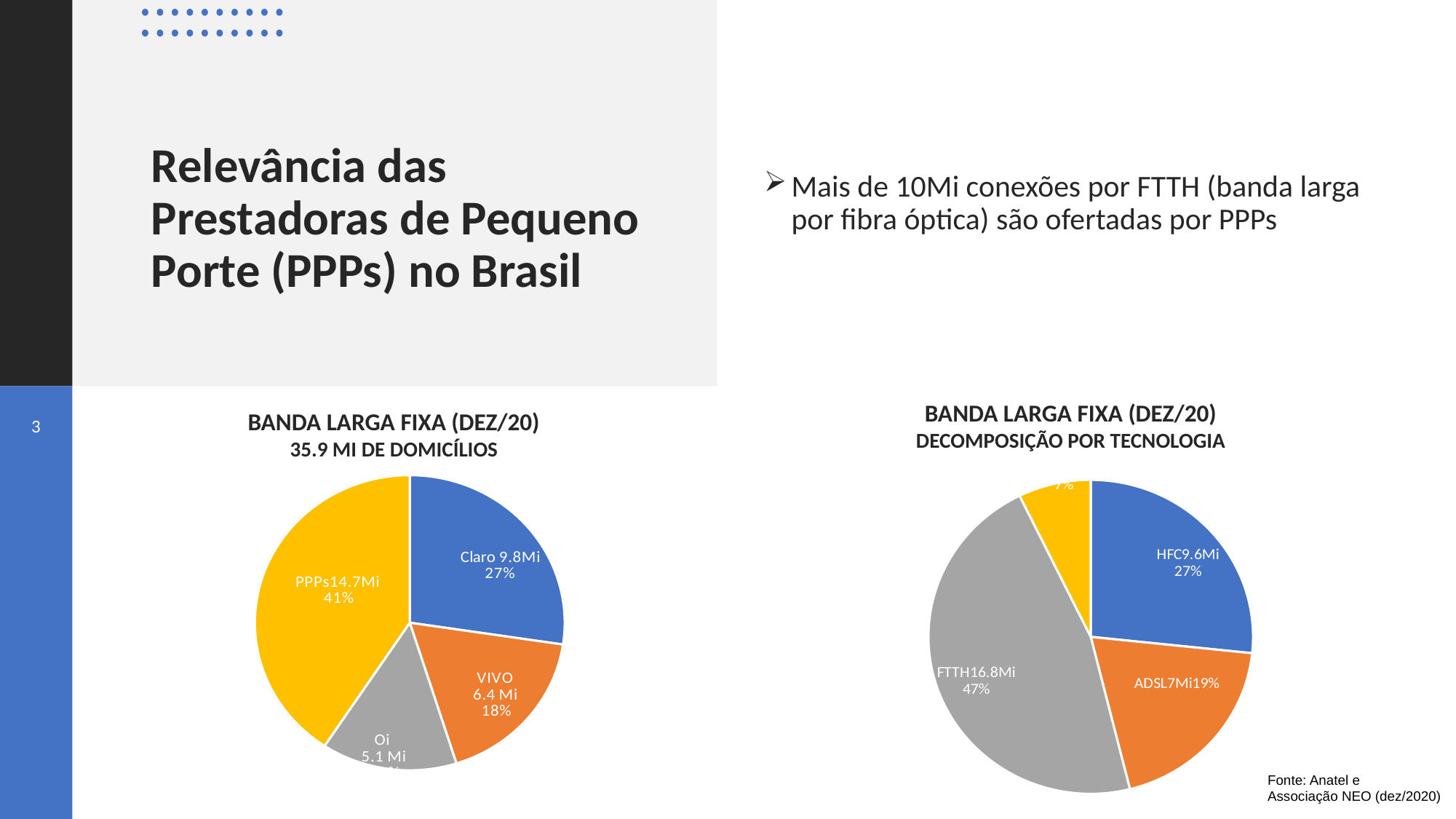
In the left pie chart (35.9 MI DE DOMICÍLIOS), what share of the pie does VIVO hold? 18% In the left pie chart (35.9 MI DE DOMICÍLIOS), what is the difference in percentage points between the PPPs share and the Claro share? 14 percentage points In the left pie chart (35.9 MI DE DOMICÍLIOS), how many slices does the pie have? 4 In the right pie chart (DECOMPOSIÇÃO POR TECNOLOGIA), which is larger, HFC or ADSL? HFC In the left pie chart (35.9 MI DE DOMICÍLIOS), what value is shown for Claro? 9.8Mi In the left pie chart (35.9 MI DE DOMICÍLIOS), which category has the smallest slice? Oi What kind of chart is the 'BANDA LARGA FIXA (DEZ/20) 35.9 MI DE DOMICÍLIOS' chart on the left? Pie chart In the right pie chart (DECOMPOSIÇÃO POR TECNOLOGIA), what value is shown for FTTH? 16.8Mi In the right pie chart (DECOMPOSIÇÃO POR TECNOLOGIA), which technology has the largest slice? FTTH In the left pie chart (35.9 MI DE DOMICÍLIOS), which category has the largest slice? PPPs In the left pie chart (35.9 MI DE DOMICÍLIOS), what value is shown for PPPs? 14.7Mi In the right pie chart (DECOMPOSIÇÃO POR TECNOLOGIA), what share of the pie does ADSL hold? 19%